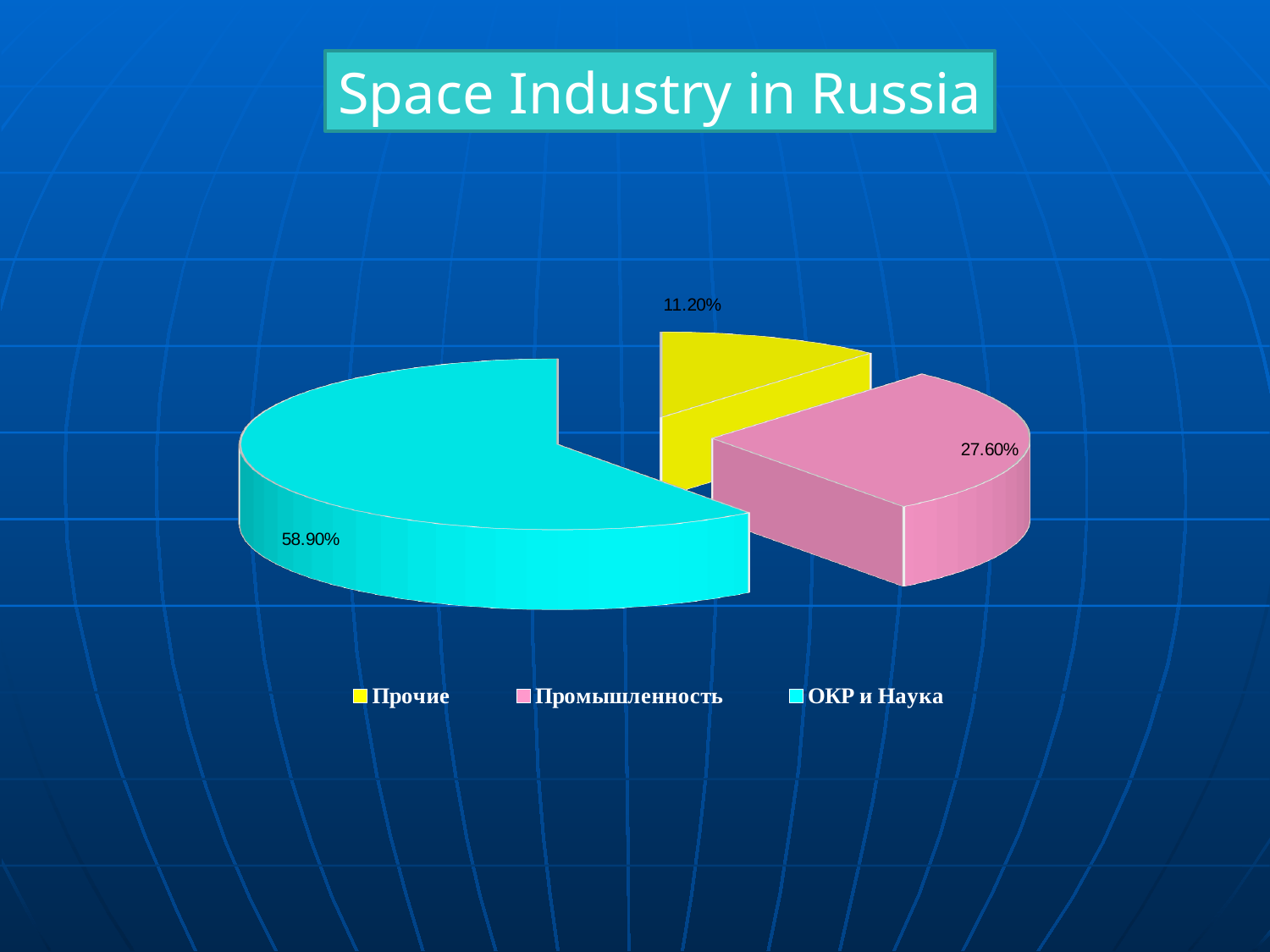
What is the title of the slide containing the chart? Space Industry in Russia What share of the pie does "Промышленность" have? 27.60% What is the difference between the shares of "Промышленность" and "Прочие"? 16.40% What kind of chart is shown on the slide? pie chart What colour is the slice for "Прочие"? yellow Which category has the largest slice of the pie? ОКР и Наука Which category has the smallest slice of the pie? Прочие What is the difference between the shares of "ОКР и Наука" and "Промышленность"? 31.30% What share of the pie does "ОКР и Наука" have? 58.90% How many slices does the pie chart have? 3 Which is larger, the share of "Промышленность" or the share of "Прочие"? Промышленность What share of the pie does "Прочие" have? 11.20%